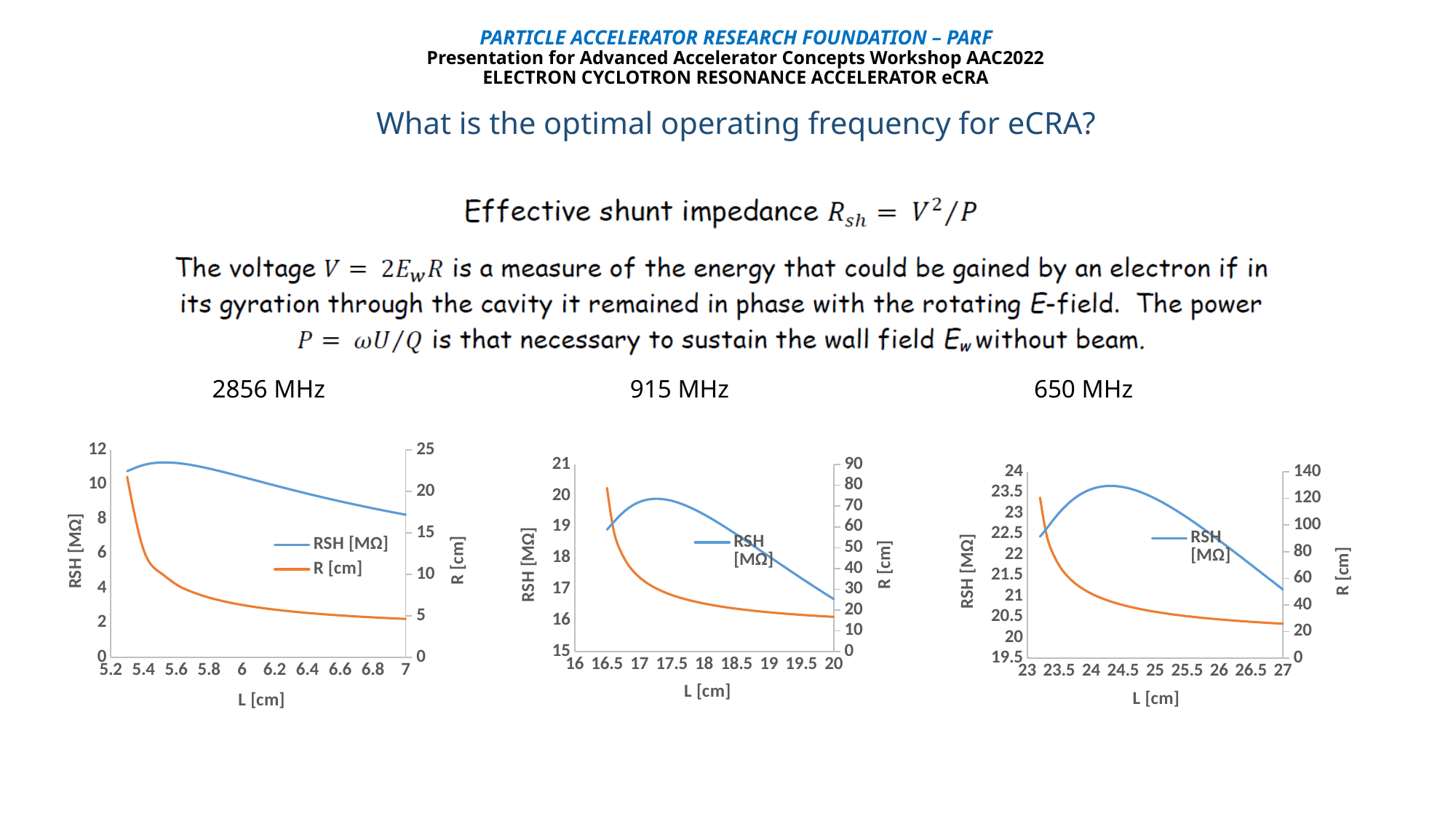
In the 915 MHz chart, is the R value at L = 20 cm greater or less than 20? less In the 650 MHz chart, does the orange R curve rise or fall as L increases from 23 to 27 cm? falls In the 2856 MHz chart, does the R [cm] curve rise or fall as L increases? falls In the 2856 MHz chart, is the RSH value at L = 7 cm greater or less than 10? less What is the label of the right-hand y-axis of the 650 MHz chart? R [cm] How many charts are shown on the slide? 3 What kind of chart is the 2856 MHz chart? line chart How many series does the legend of the 2856 MHz chart list? 2 In the 650 MHz chart, is the R value at L = 27 cm greater or less than 40? less What is the x-axis label of the 915 MHz chart? L [cm]